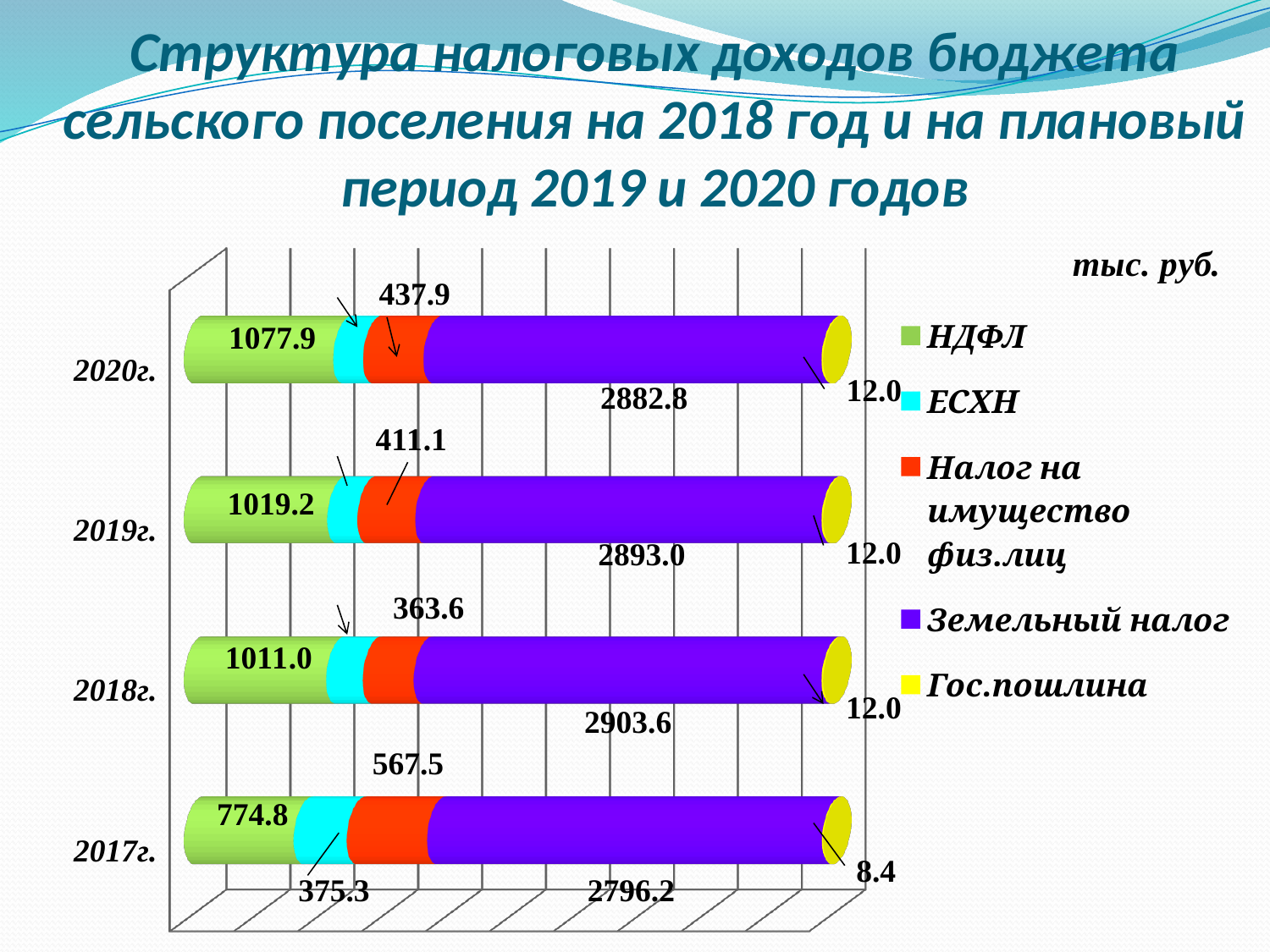
What is the value of Земельный налог for 2018г.? 2903.6 What is the value of Налог на имущество физ.лиц for 2019г.? 411.1 Which year has the lowest value for НДФЛ? 2017г. What is the value of НДФЛ for 2020г.? 1077.9 Which year has the larger value for Налог на имущество физ.лиц, 2017г. or 2020г.? 2017г. Which year has the highest value for Земельный налог? 2018г. How many years are shown on the chart? 4 What is the total of the stacked bar for 2017г.? 4522.2 How many series does the legend list? 5 What is the value of Гос.пошлина for 2017г.? 8.4 What kind of chart is shown on the slide? Stacked bar chart What is the difference between the НДФЛ values for 2020г. and 2019г.? 58.7